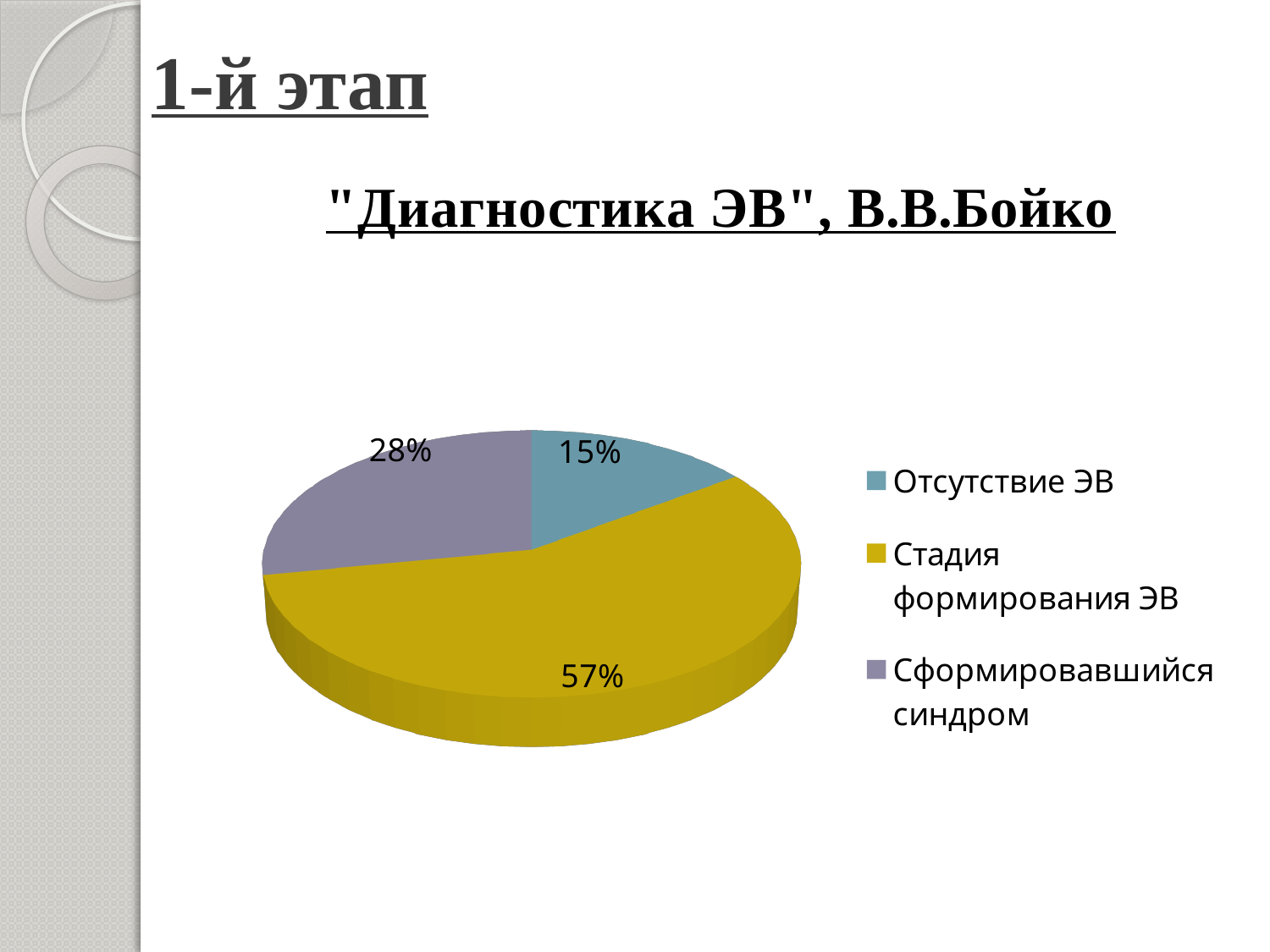
What is the difference in percentage points between "Стадия формирования ЭВ" and "Сформировавшийся синдром"? 29 What percentage is shown for "Стадия формирования ЭВ"? 57% What colour is the slice for "Стадия формирования ЭВ"? yellow What is the title of the chart? "Диагностика ЭВ", В.В.Бойко What kind of chart is shown on the slide? pie chart Which category has the smallest slice of the pie? Отсутствие ЭВ What percentage is shown for "Отсутствие ЭВ"? 15% Which is larger: the slice for "Сформировавшийся синдром" or the slice for "Отсутствие ЭВ"? Сформировавшийся синдром How many categories does the pie chart have? 3 What percentage is shown for "Сформировавшийся синдром"? 28% What is the difference in percentage points between "Сформировавшийся синдром" and "Отсутствие ЭВ"? 13 Which category has the largest slice of the pie? Стадия формирования ЭВ